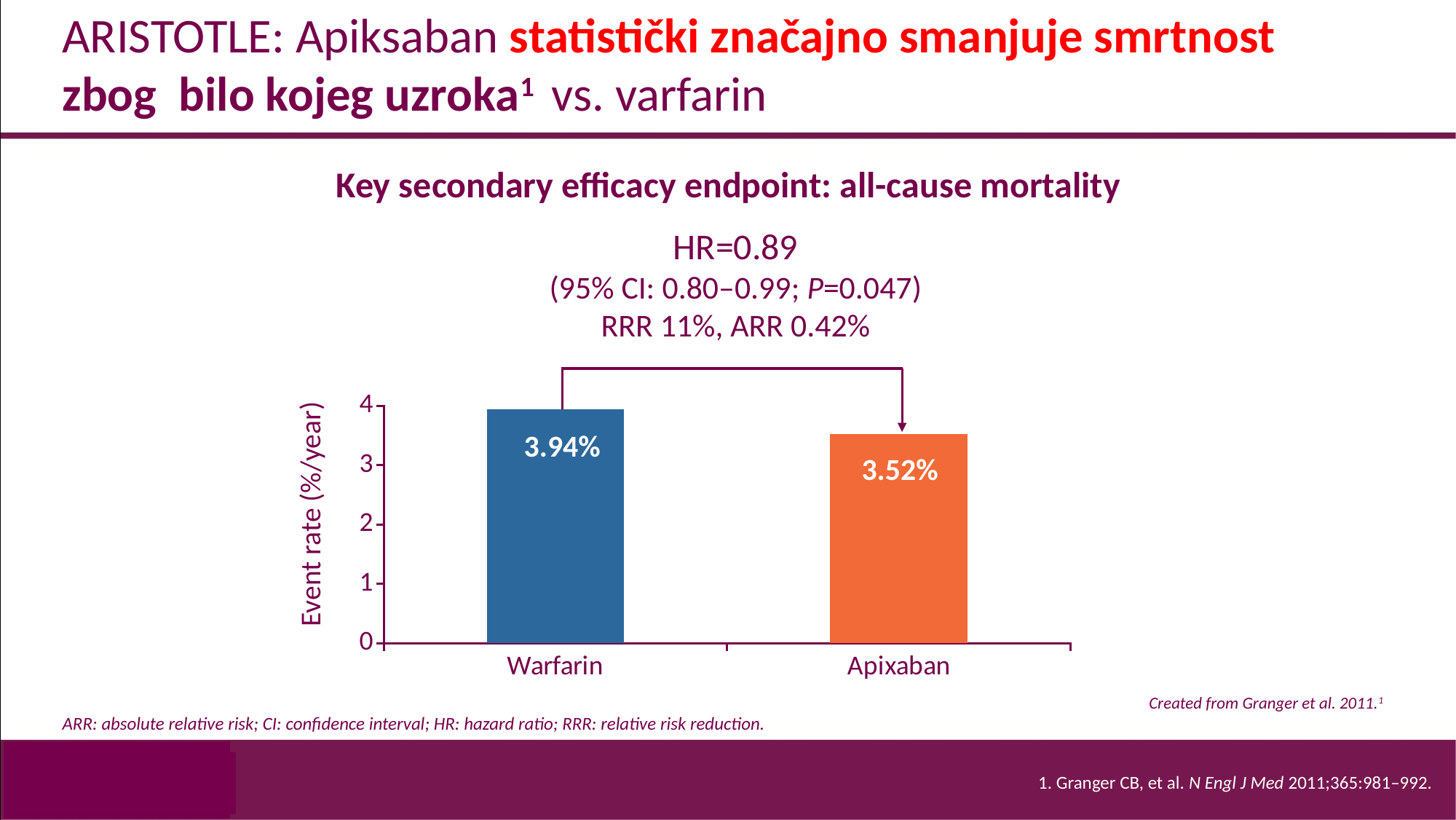
What is the event rate for Warfarin? 3.94% What is the label of the y axis? Event rate (%/year) Is the value for Apixaban greater or less than 4? less Which treatment has the higher event rate? Warfarin Is the event rate for Warfarin or Apixaban larger? Warfarin Is the value for Warfarin greater or less than 3? greater What is the event rate for Apixaban? 3.52% What is the difference in event rate between Warfarin and Apixaban? 0.42% Which treatment has the lower event rate? Apixaban What kind of chart is shown on the slide? bar chart How many treatment categories are shown in the chart? 2 What colour is the Apixaban bar? orange